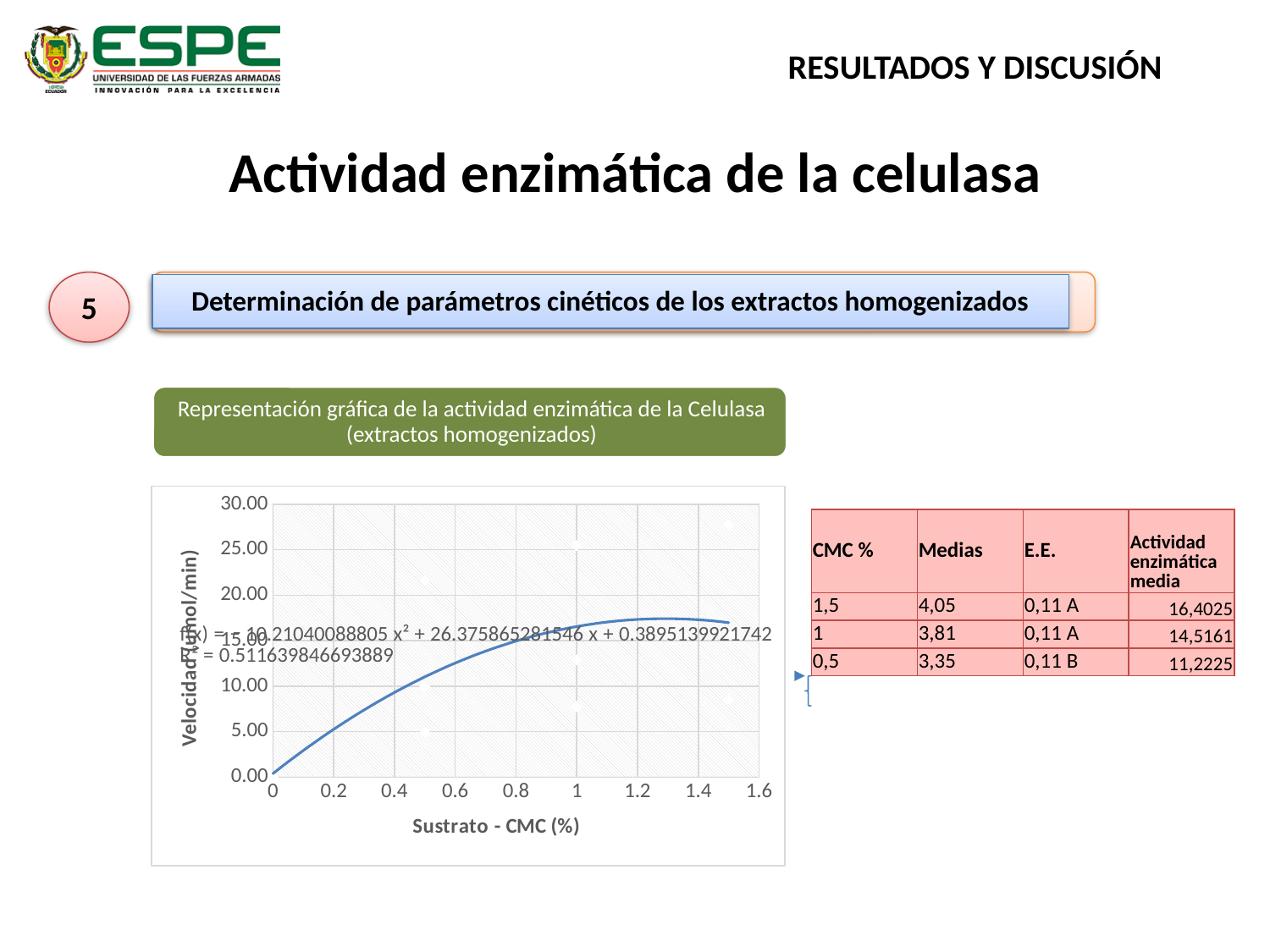
Is the value of the fitted curve at a substrate concentration of 1.4 greater or less than 20? less What is the maximum value shown on the x axis of the chart? 1.6 What kind of chart is shown on the slide? Scatter chart with a trendline What is the maximum value shown on the y axis of the chart? 30.00 Is the value of the fitted curve at a substrate concentration of 0.8 greater or less than 10? greater Is the value of the fitted curve at a substrate concentration of 0.2 greater or less than 10? less What is the title of the y axis of the chart? Velocidad (μmol/min) Does the fitted curve rise or fall as the substrate concentration increases from 0 to 1? Rises